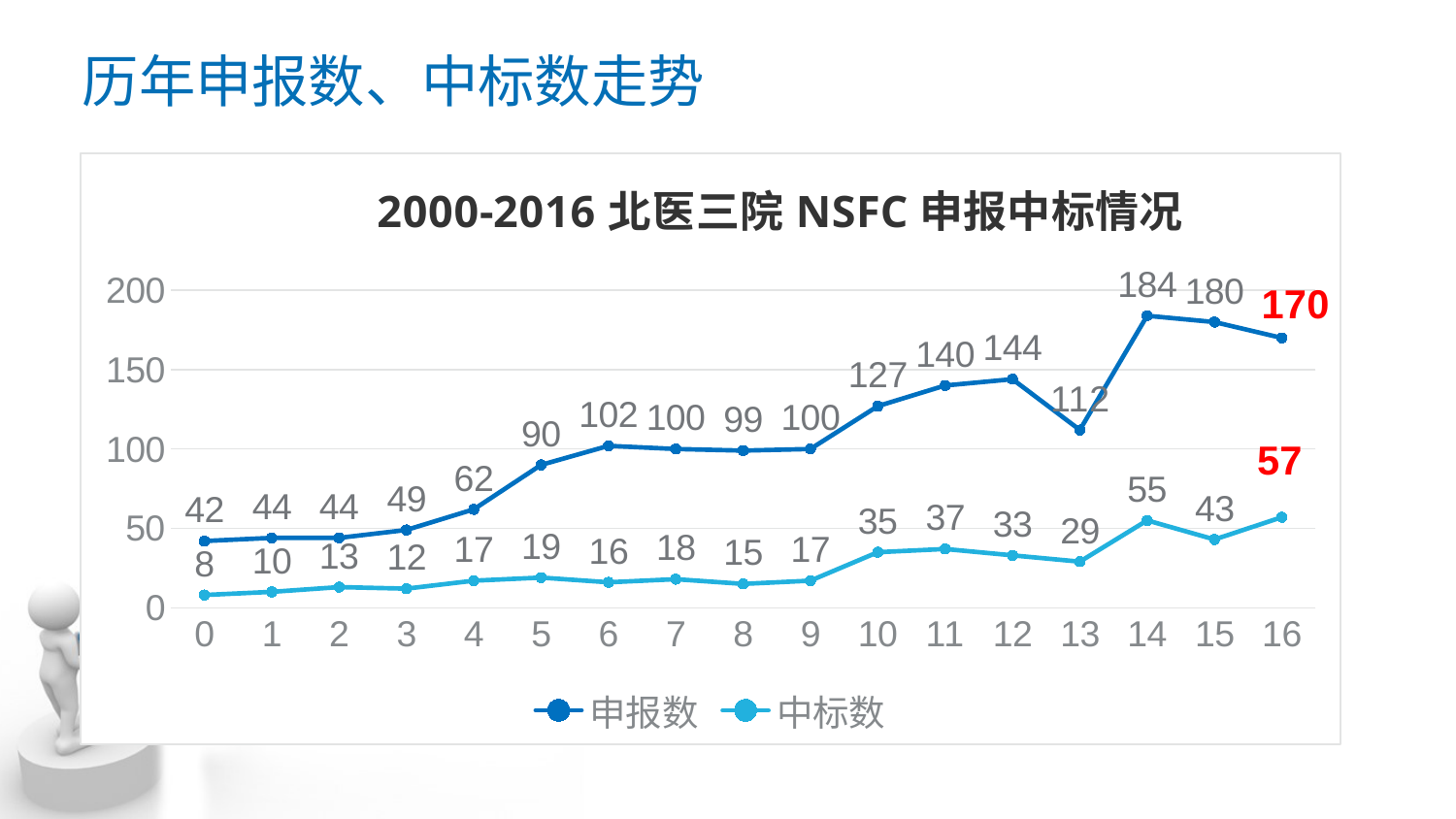
What is the value of 申报数 at x = 0? 42 Does 申报数 rise or fall from x = 14 to x = 16? fall What kind of chart is shown? line chart At which x value is 申报数 highest? 14 How many data points does each series have? 17 Which is larger: 申报数 at x = 13 or 申报数 at x = 12? 申报数 at x = 12 What is the value of 中标数 at x = 16? 57 What is the value of 申报数 at x = 14? 184 What is the difference between 申报数 and 中标数 at x = 16? 113 What is the title of the chart? 2000-2016 北医三院 NSFC 申报中标情况 At which x value is 中标数 lowest? 0 How many series does the legend list? 2